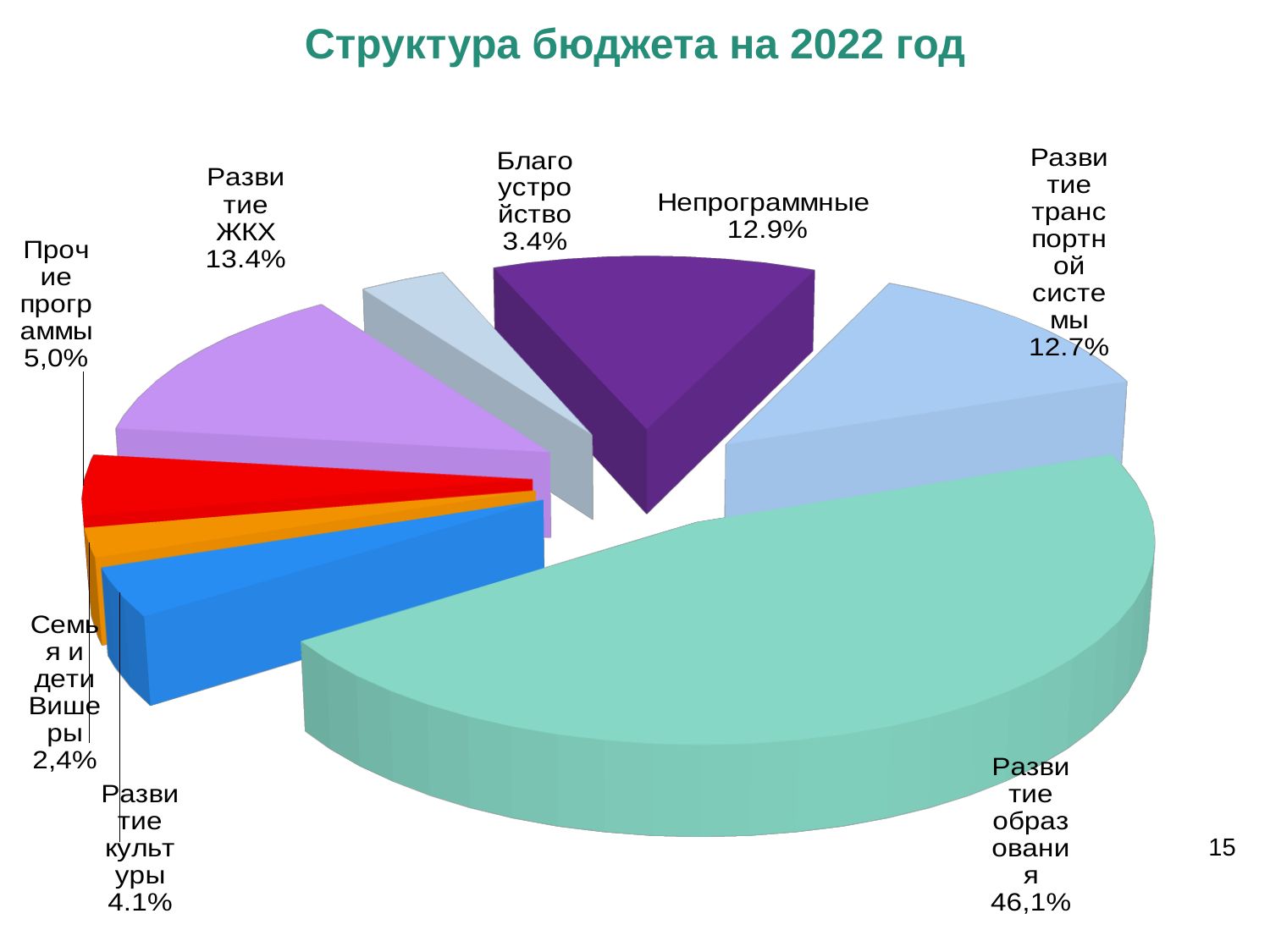
What is the difference between the shares for Развитие культуры and Благоустройство? 0.7% Which category has the largest share of the budget? Развитие образования What colour is the slice for Непрограммные? Purple What share is shown for Развитие ЖКХ? 13.4% How many slices does the pie chart have? 8 What is the title of the chart? Структура бюджета на 2022 год What share of the budget is labelled for Развитие образования? 46,1% What kind of chart is shown on the slide? Pie chart Which category has the smallest share of the budget? Семья и дети Вишеры What share is shown for Семья и дети Вишеры? 2,4% Which is larger, the share for Развитие ЖКХ or the share for Прочие программы? Развитие ЖКХ What share is shown for Непрограммные? 12.9%